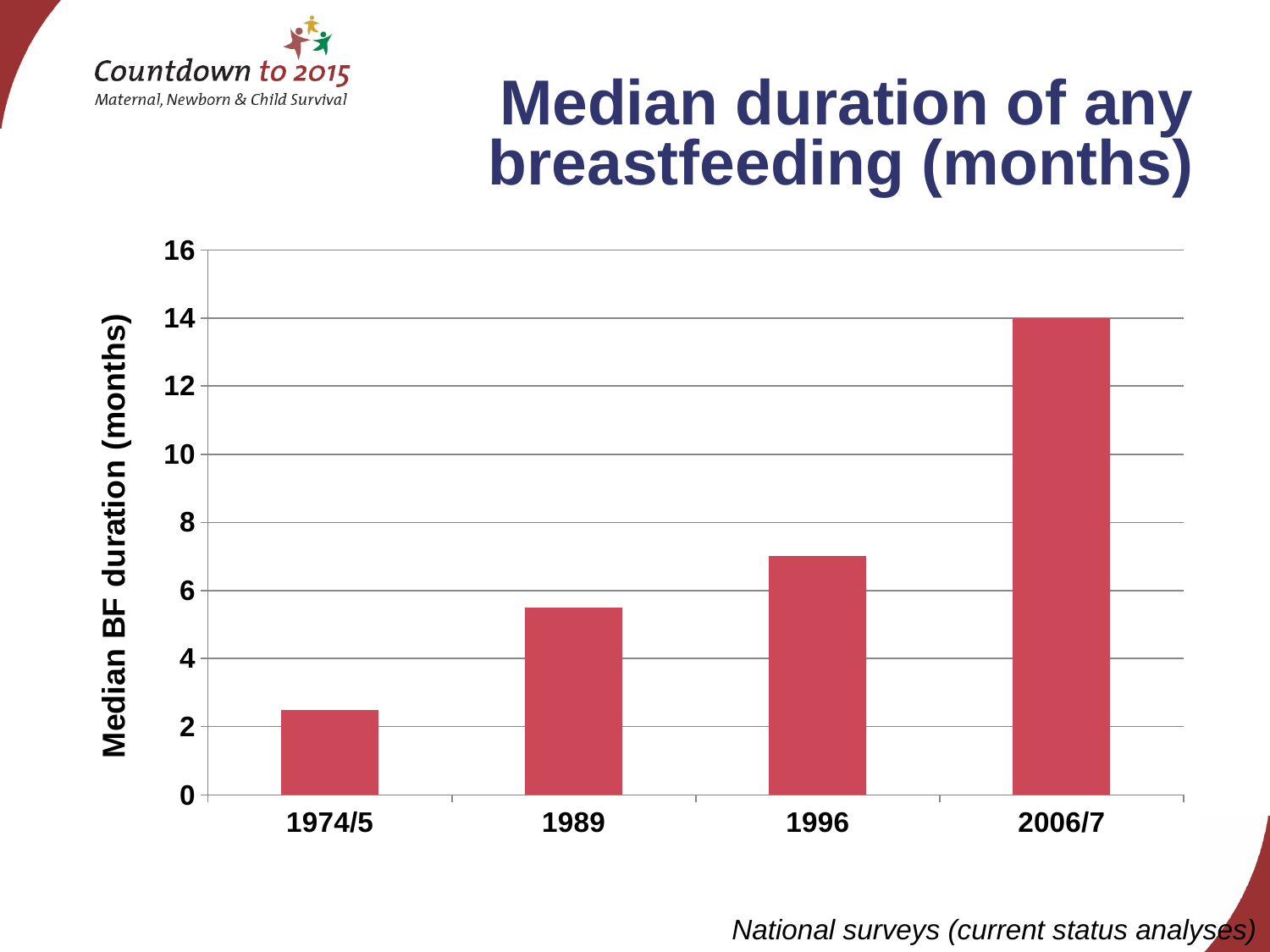
What is the label on the y axis of the chart? Median BF duration (months) Which survey year has the highest median breastfeeding duration? 2006/7 Do the values rise or fall from 1974/5 to 2006/7? rise Is the value for 1989 greater or less than 4? greater Is the value for 1996 greater or less than 8? less What kind of chart is shown on the slide? bar chart Is the value for 1974/5 greater or less than 4? less Which survey year has the lowest median breastfeeding duration? 1974/5 How many survey years are shown on the x axis of the chart? 4 Which has a larger median breastfeeding duration, 1989 or 1996? 1996 What is the median breastfeeding duration in months for 2006/7? 14